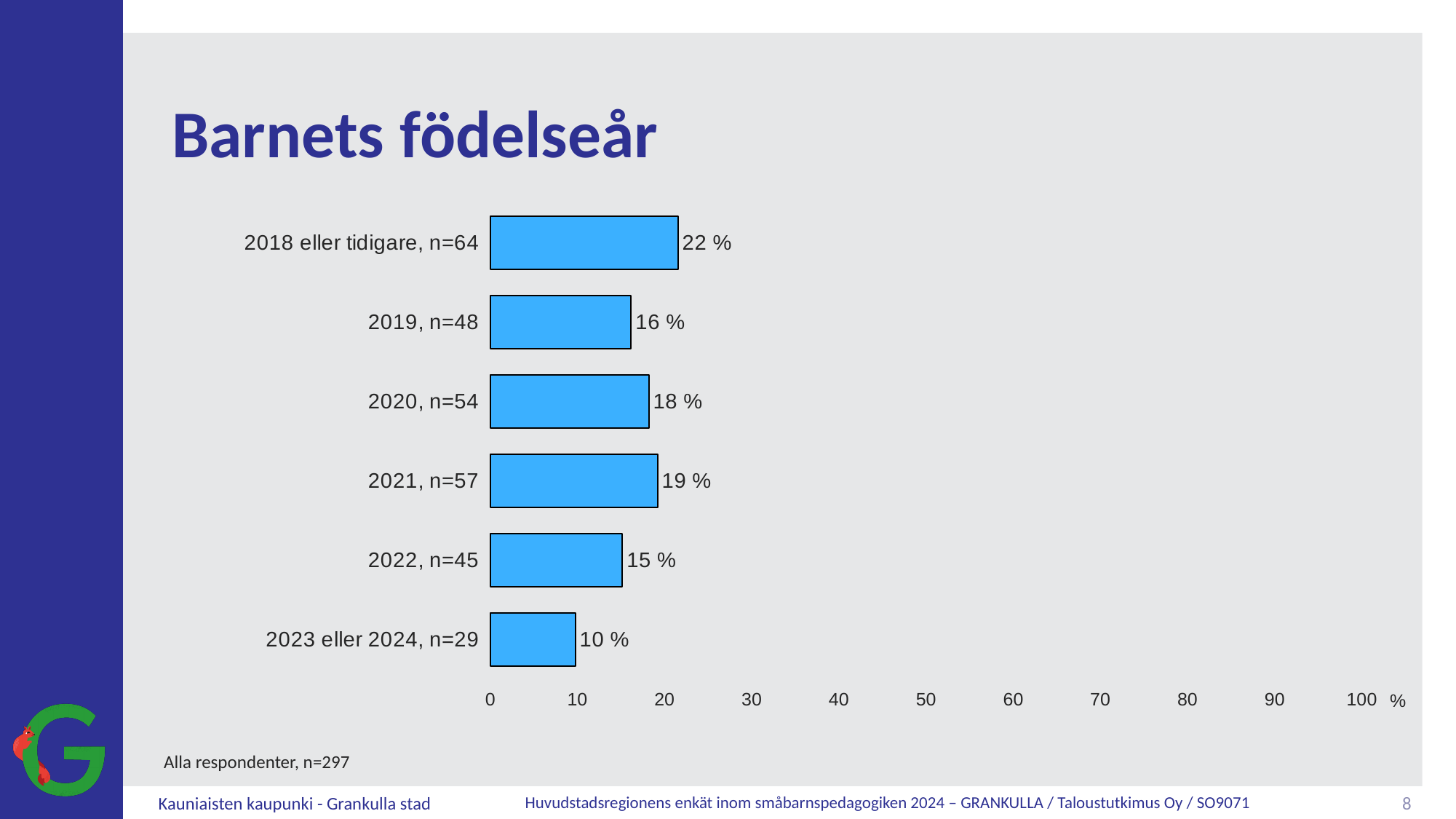
What kind of chart is shown on the slide? bar chart What percentage is shown for the category "2020, n=54"? 18 % What is the difference in percentage points between "2021, n=57" and "2019, n=48"? 3 What is the title of the slide? Barnets födelseår What is the total number of respondents stated below the chart? n=297 Is the value for "2018 eller tidigare, n=64" greater or less than 20? greater Which category has the lowest percentage? 2023 eller 2024, n=29 What percentage is shown for the category "2018 eller tidigare, n=64"? 22 % How many categories are shown in the chart? 6 What percentage is shown for the category "2022, n=45"? 15 % Which has a larger percentage, "2020, n=54" or "2022, n=45"? 2020, n=54 Which category has the highest percentage? 2018 eller tidigare, n=64